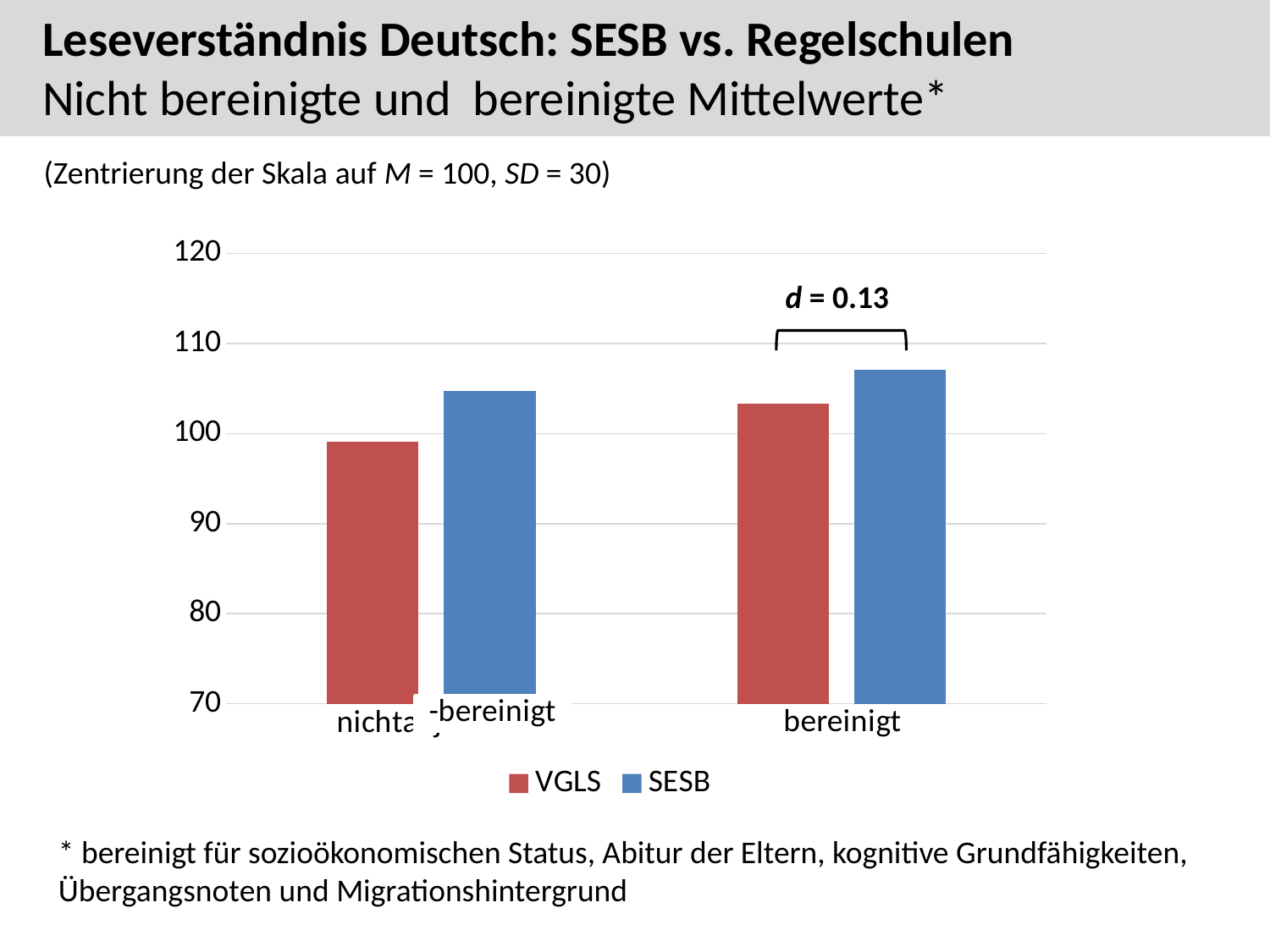
Is the SESB value in the 'nicht bereinigt' group greater or less than 100? greater How many series does the legend list? 2 What kind of chart is shown on the slide? bar chart Which bar is the highest in the chart? SESB, bereinigt Is the VGLS value in the 'bereinigt' group greater or less than 100? greater In the 'nicht bereinigt' group, which series has the higher value, VGLS or SESB? SESB How many category groups are shown on the x axis? 2 What effect size d is annotated above the 'bereinigt' group? d = 0.13 Is the VGLS value in the 'nicht bereinigt' group greater or less than 100? less Which bar is the lowest in the chart? VGLS, nicht bereinigt In the 'bereinigt' group, which series has the higher value, VGLS or SESB? SESB